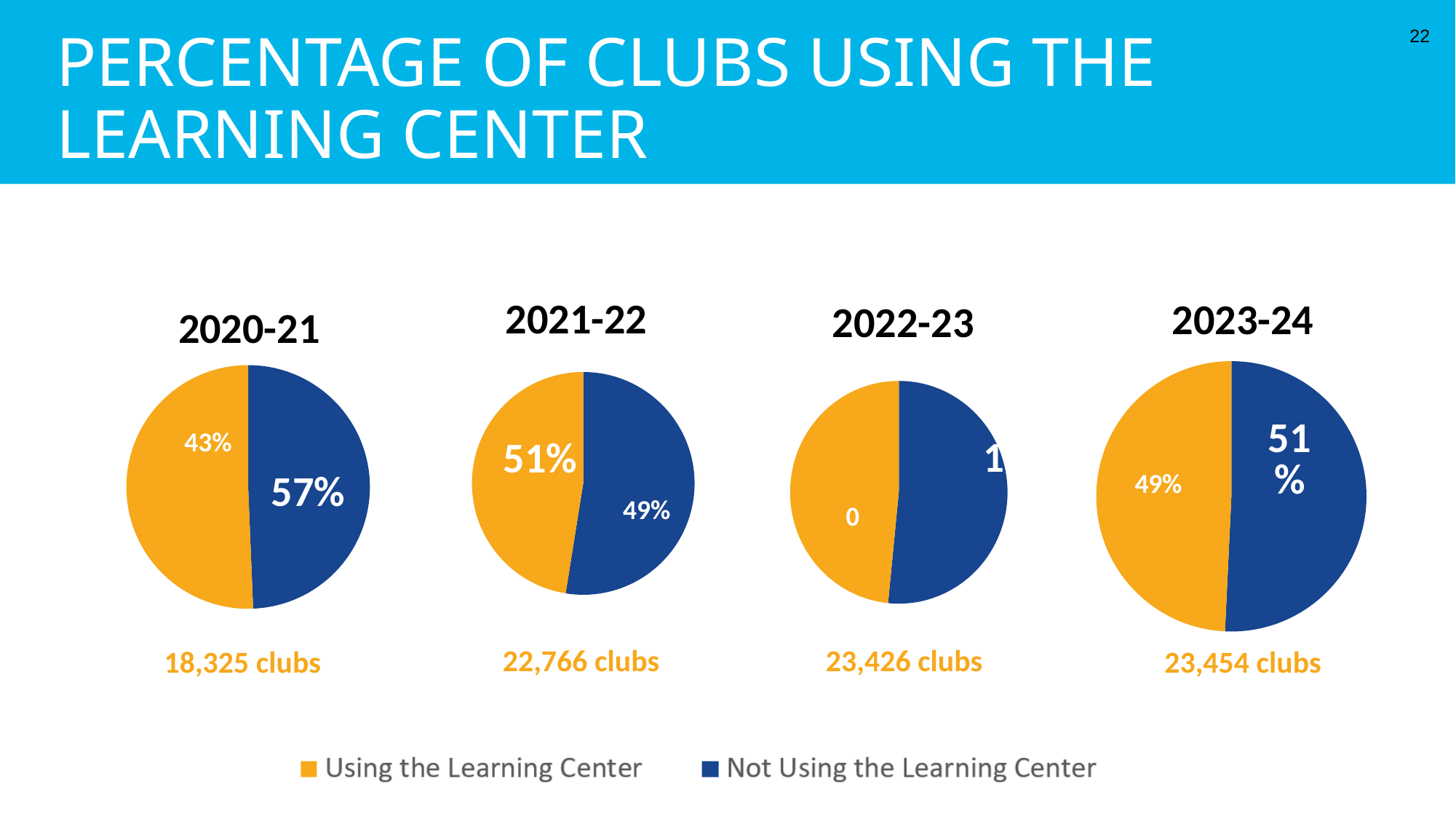
In the 2020-21 pie chart, what percentage of clubs were using the Learning Center? 43% How many pie charts are shown on the slide? 4 In the 2020-21 pie chart, which slice is larger: Using the Learning Center or Not Using the Learning Center? Not Using the Learning Center In the 2023-24 pie chart, what percentage of clubs were not using the Learning Center? 51% How many series does the legend list? 2 In the 2023-24 pie chart, what percentage of clubs were using the Learning Center? 49% In the 2020-21 pie chart, what percentage of clubs were not using the Learning Center? 57% In the 2021-22 pie chart, what percentage of clubs were not using the Learning Center? 49% In the 2020-21 pie chart, what is the difference in percentage points between clubs not using and clubs using the Learning Center? 14% In the 2021-22 pie chart, what percentage of clubs were using the Learning Center? 51% What kind of chart is used on this slide? Pie chart How many clubs are reported under the 2021-22 pie chart? 22,766 clubs